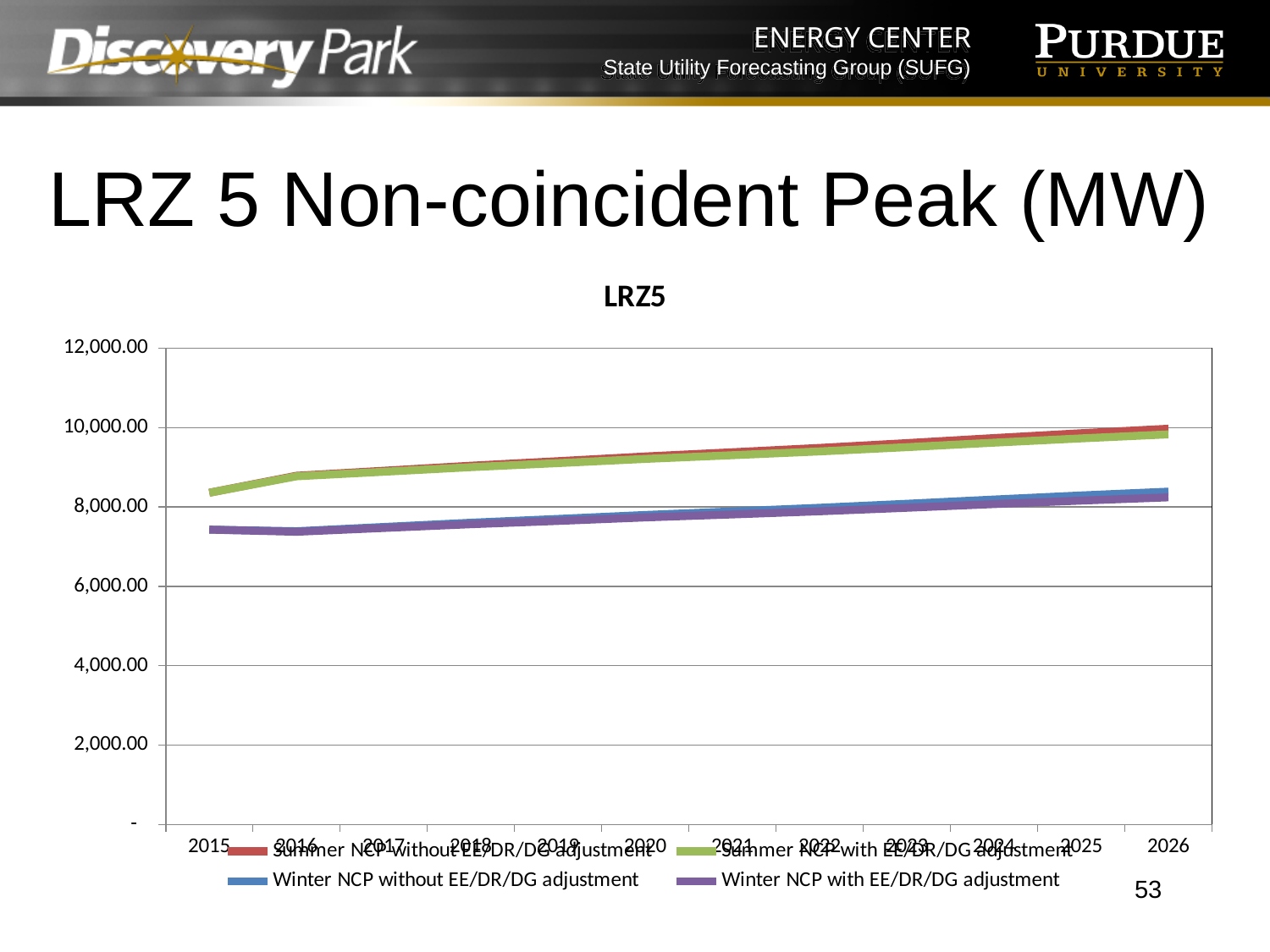
What is the last year shown on the x axis? 2026 What is the first year shown on the x axis? 2015 In 2020, which is larger: Summer NCP without EE/DR/DG adjustment or Winter NCP without EE/DR/DG adjustment? Summer NCP without EE/DR/DG adjustment Is the value for Winter NCP with EE/DR/DG adjustment in 2015 greater or less than 8,000? less What kind of chart is shown on the slide? line chart What is the highest value shown on the y axis? 12,000.00 How many years are shown along the x axis? 12 Is the value for Summer NCP without EE/DR/DG adjustment in 2015 greater or less than 8,000? greater Is the value for Summer NCP with EE/DR/DG adjustment in 2015 greater or less than 10,000? less What is the title of the chart? LRZ5 Do the Summer NCP without EE/DR/DG adjustment values rise or fall from 2015 to 2026? rise How many series does the legend list? 4